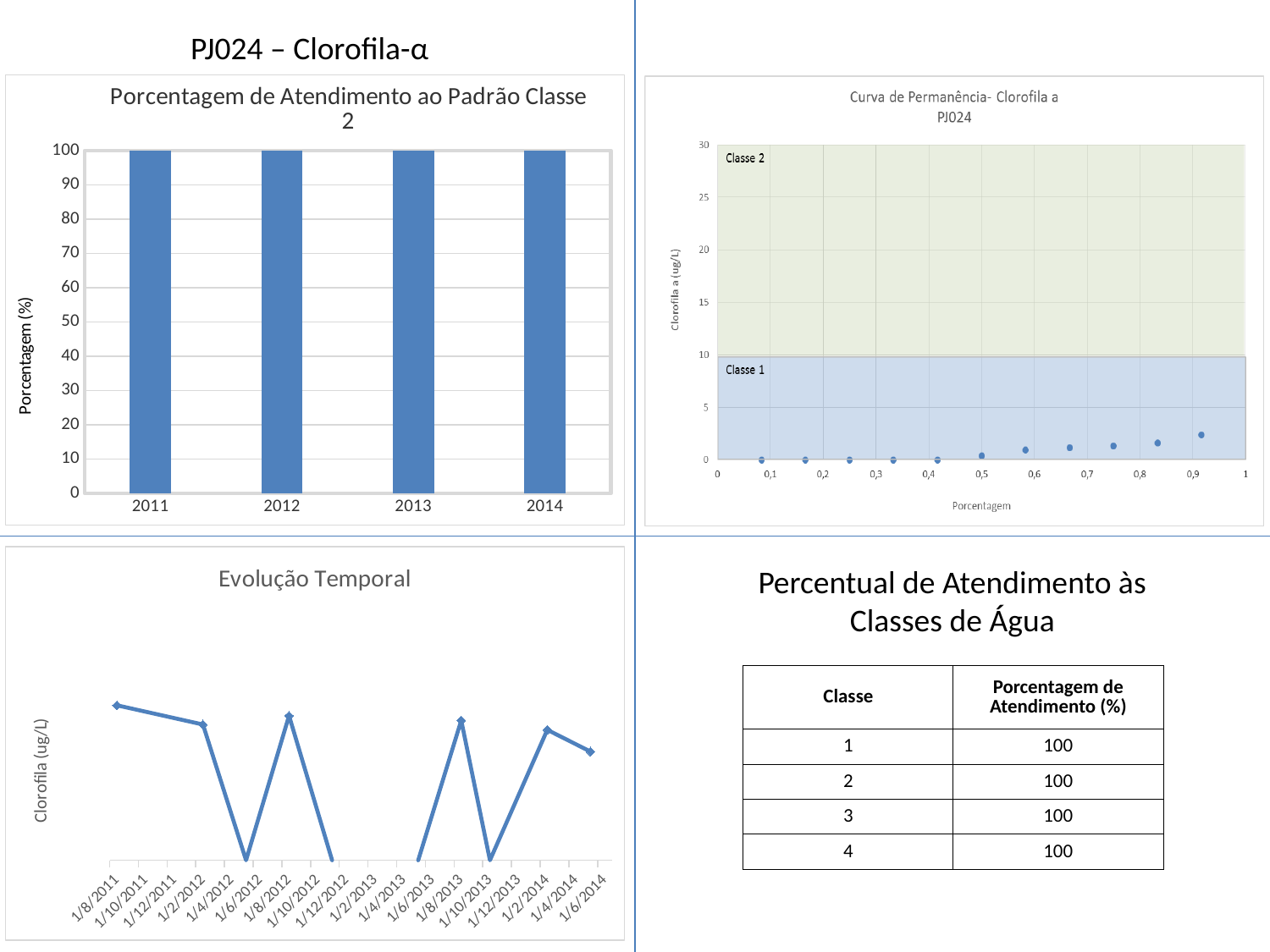
In the chart titled "Curva de Permanência- Clorofila a PJ024", do the plotted values rise or fall as the x axis increases? rise In the chart titled "Curva de Permanência- Clorofila a PJ024", is the value of the point at 0.9 on the x axis greater or less than 5? less In the chart titled "Porcentagem de Atendimento ao Padrão Classe 2", what is the value for 2011? 100 In the chart titled "Porcentagem de Atendimento ao Padrão Classe 2", what is the y-axis title? Porcentagem (%) In the chart titled "Porcentagem de Atendimento ao Padrão Classe 2", how many years are shown on the x axis? 4 In the chart titled "Curva de Permanência- Clorofila a PJ024", is the value of the point at 0.1 on the x axis greater or less than 5? less In the chart titled "Curva de Permanência- Clorofila a PJ024", what are the two shaded regions labelled? Classe 2 and Classe 1 What kind of chart is the one titled "Porcentagem de Atendimento ao Padrão Classe 2"? bar chart In the chart titled "Porcentagem de Atendimento ao Padrão Classe 2", what is the difference between the values for 2012 and 2013? 0 In the chart titled "Evolução Temporal", what is the y-axis title? Clorofila (ug/L) In the chart titled "Porcentagem de Atendimento ao Padrão Classe 2", what is the value for 2014? 100 What kind of chart is the one titled "Evolução Temporal"? line chart